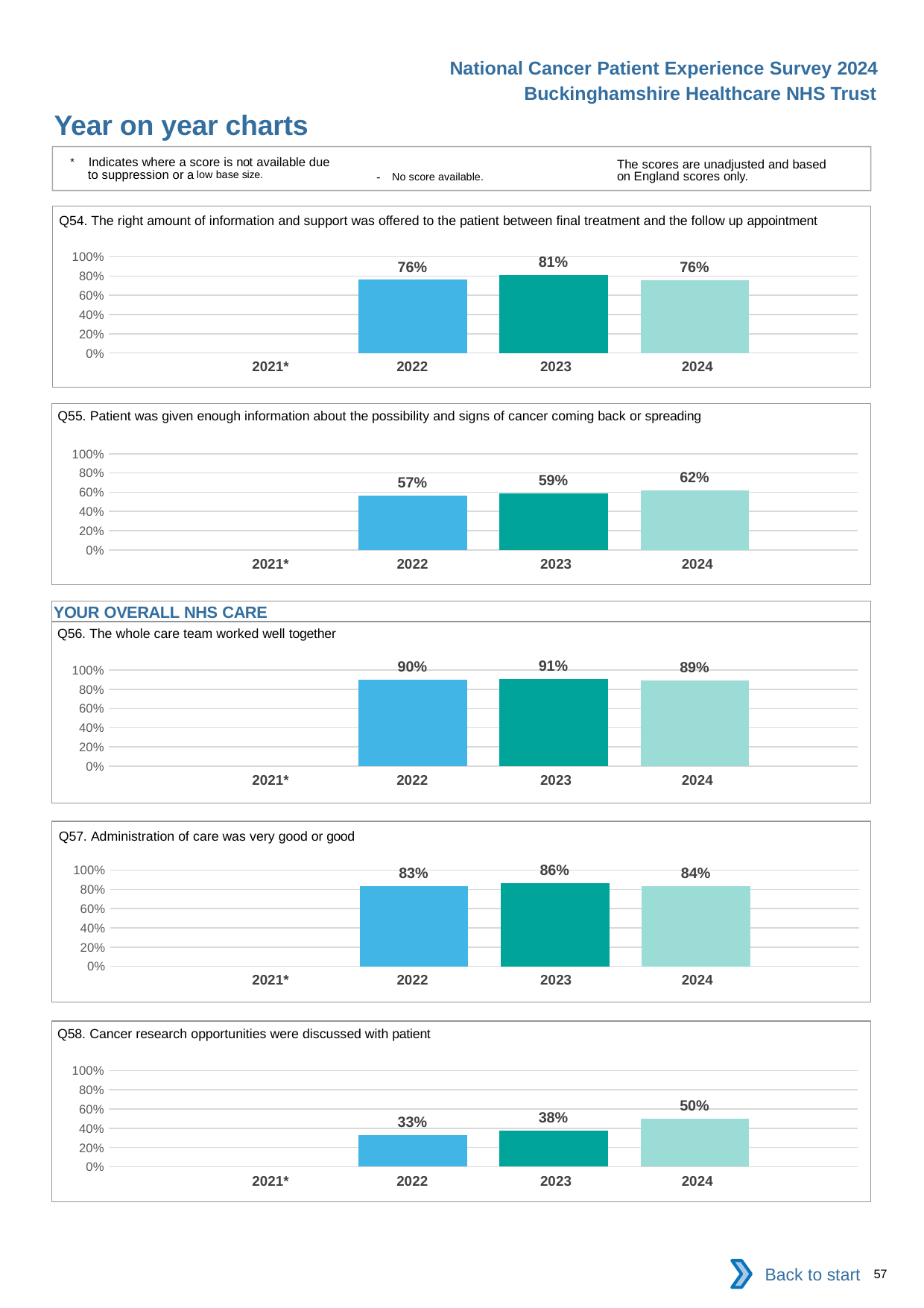
What kind of chart is the Q57 chart? bar chart In the Q57 chart, which is larger, the value for 2022 or the value for 2024? 2024 In the Q54 chart, what is the value for 2023? 81% In the Q56 chart, which year has the highest value? 2023 In the Q58 chart, do the values rise or fall from 2022 to 2024? rise In the Q54 chart, how many years are shown on the x axis? 4 In the Q58 chart, what is the difference between the 2024 and 2022 values? 17% Which year is marked with an asterisk on the x axis of the Q54 chart? 2021* In the Q56 chart, what is the difference between the 2023 and 2024 values? 2% In the Q55 chart, is the value for 2022 greater or less than 60%? less In the Q58 chart, which year has the lowest value among those with a score? 2022 In the Q55 chart, what is the value for 2024? 62%